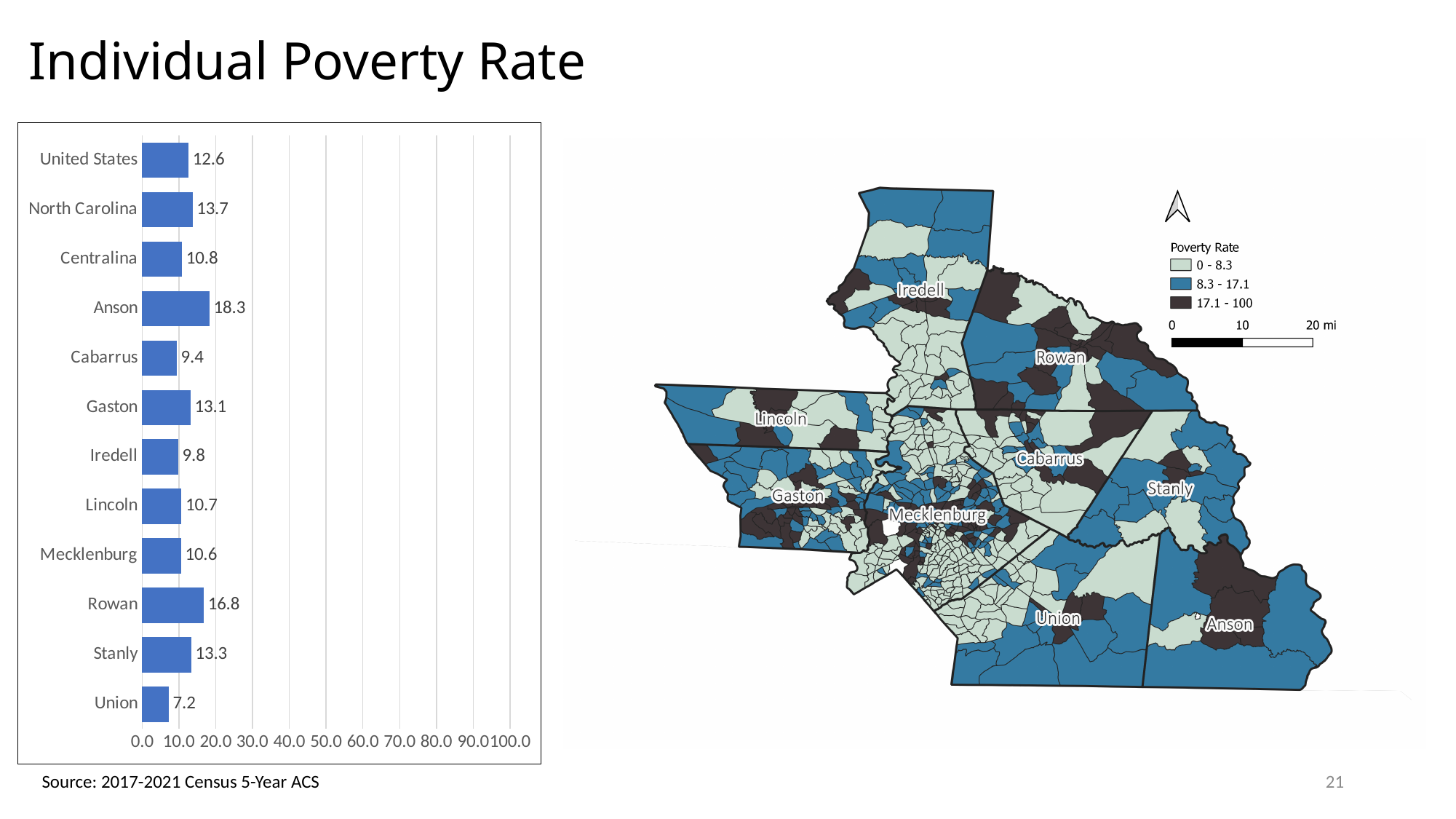
What kind of chart is used to show the individual poverty rates on the left of the slide? bar chart What is the highest value shown on the x axis of the bar chart? 100.0 Which has a higher individual poverty rate in the bar chart, Gaston or Mecklenburg? Gaston What is the individual poverty rate for Union in the bar chart? 7.2 Which category has the lowest individual poverty rate in the bar chart? Union What is the difference between the poverty rates of Rowan and Cabarrus in the bar chart? 7.4 What is the difference between the poverty rates of Centralina and the United States in the bar chart? 1.8 What is the individual poverty rate for Anson in the bar chart? 18.3 Is the value for Stanly in the bar chart greater or less than 20.0? less Which category has the highest individual poverty rate in the bar chart? Anson What is the individual poverty rate for North Carolina in the bar chart? 13.7 How many categories are shown in the bar chart? 12